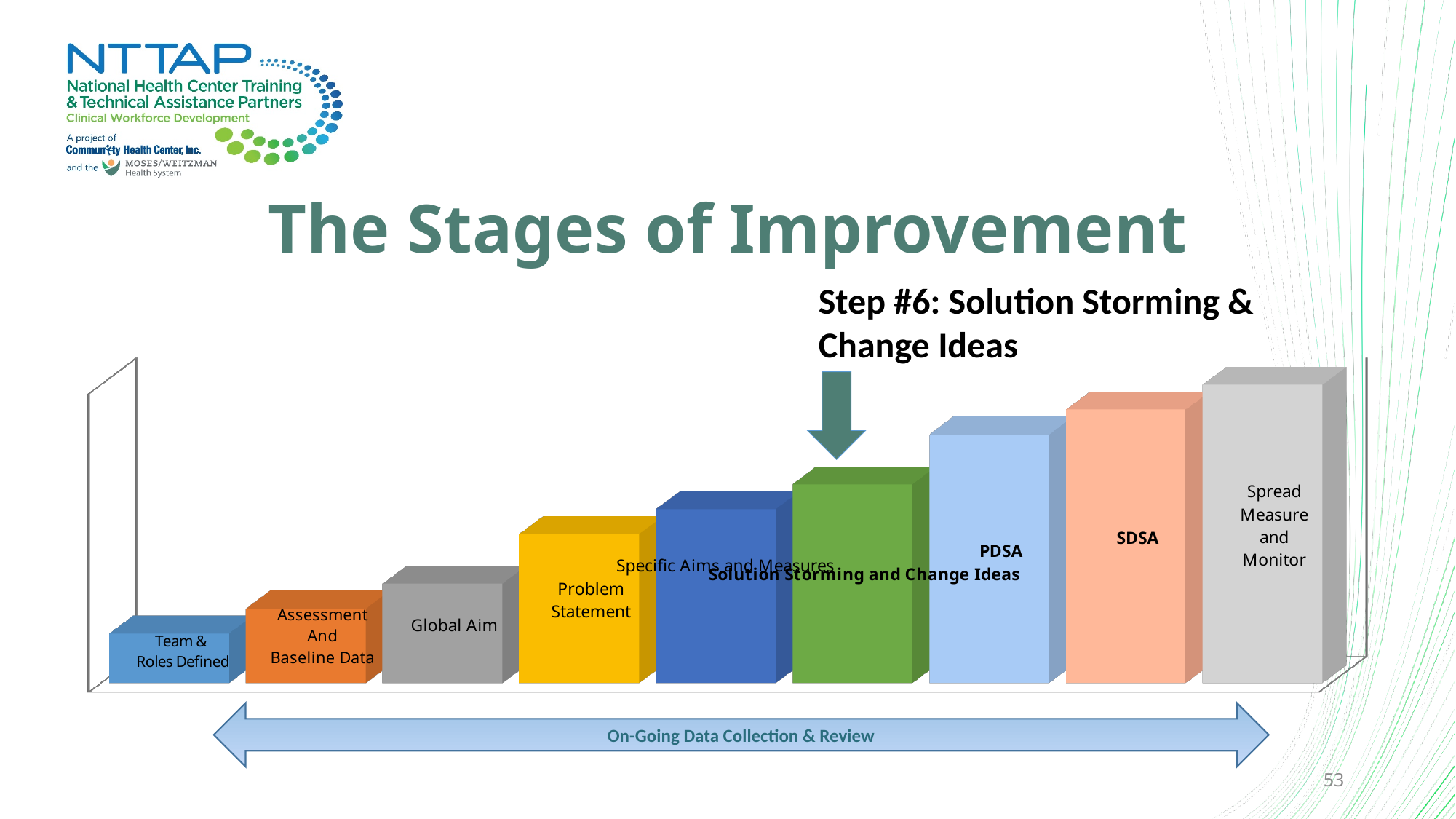
Which stage does the arrow labelled 'Step #6' point to? Solution Storming and Change Ideas What kind of chart is shown on the slide? Bar chart Which bar is taller, Global Aim or PDSA? PDSA Which stage has the tallest bar? Spread Measure and Monitor What is the label on the horizontal double-headed arrow below the bars? On-Going Data Collection & Review Which bar is shorter, SDSA or Assessment And Baseline Data? Assessment And Baseline Data What is the title of the slide containing the chart? The Stages of Improvement How many bars (stages) are shown in the chart? 9 Do the bar heights rise or fall from left to right across the chart? Rise Which stage has the shortest bar? Team & Roles Defined Which stage is the first (leftmost) bar in the chart? Team & Roles Defined Which bar is taller, Team & Roles Defined or Problem Statement? Problem Statement